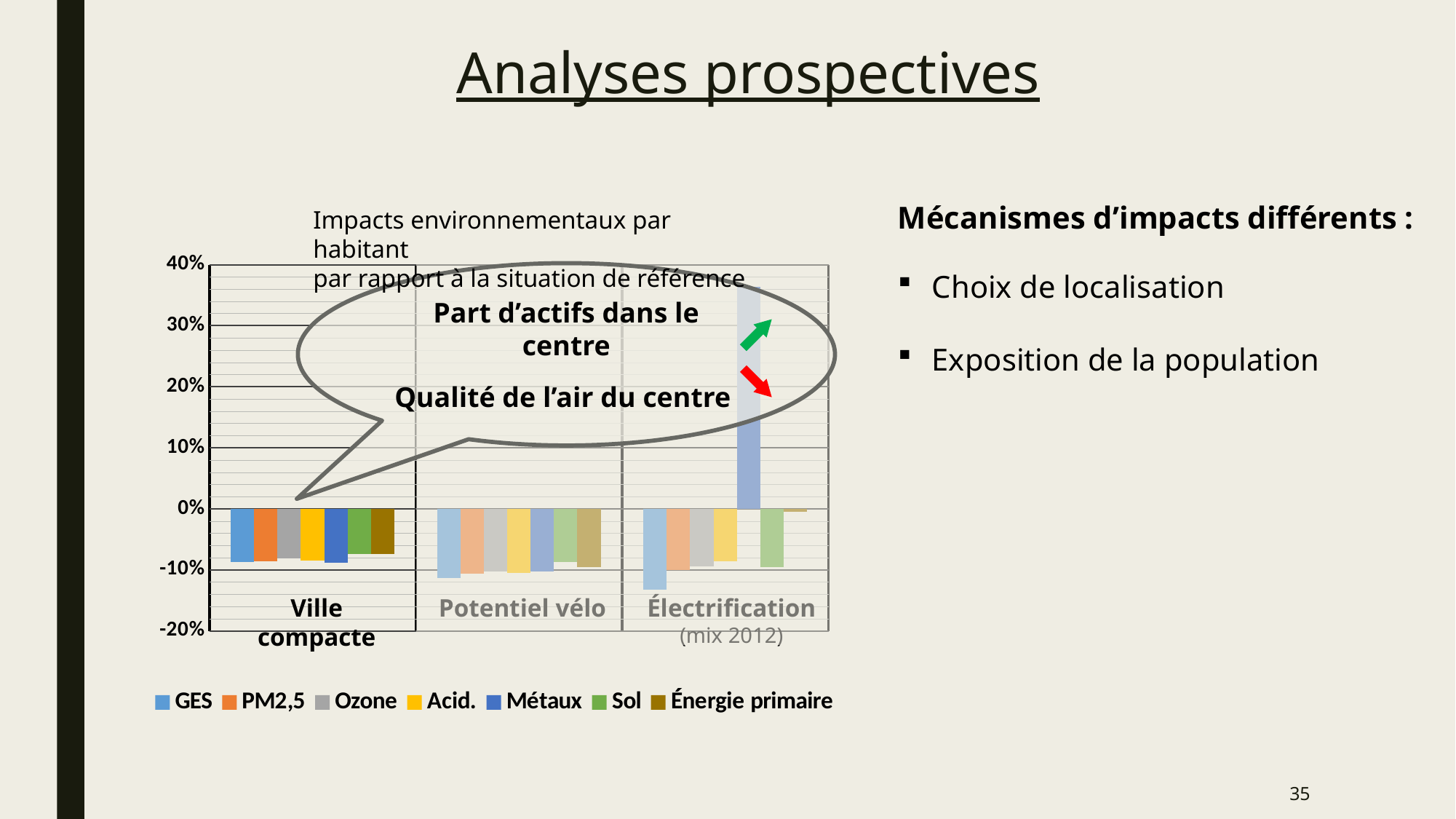
Is the value for Énergie primaire in the Électrification (mix 2012) category greater or less than -5%? greater Is the value for Métaux in the Électrification (mix 2012) category greater or less than 30%? greater Which series has the highest value in the Électrification (mix 2012) category? Métaux How many series does the chart legend list? 7 What kind of chart is shown on the slide? bar chart How many categories are shown on the x axis of the chart? 3 Which category contains the only bar with a positive value? Électrification (mix 2012) Which is larger: the value for GES in Ville compacte or the value for GES in Électrification (mix 2012)? GES in Ville compacte Is the value for GES in the Électrification (mix 2012) category greater or less than -10%? less Which is larger: the value for Métaux in Électrification (mix 2012) or the value for Métaux in Ville compacte? Métaux in Électrification (mix 2012) What is the first series listed in the chart legend? GES